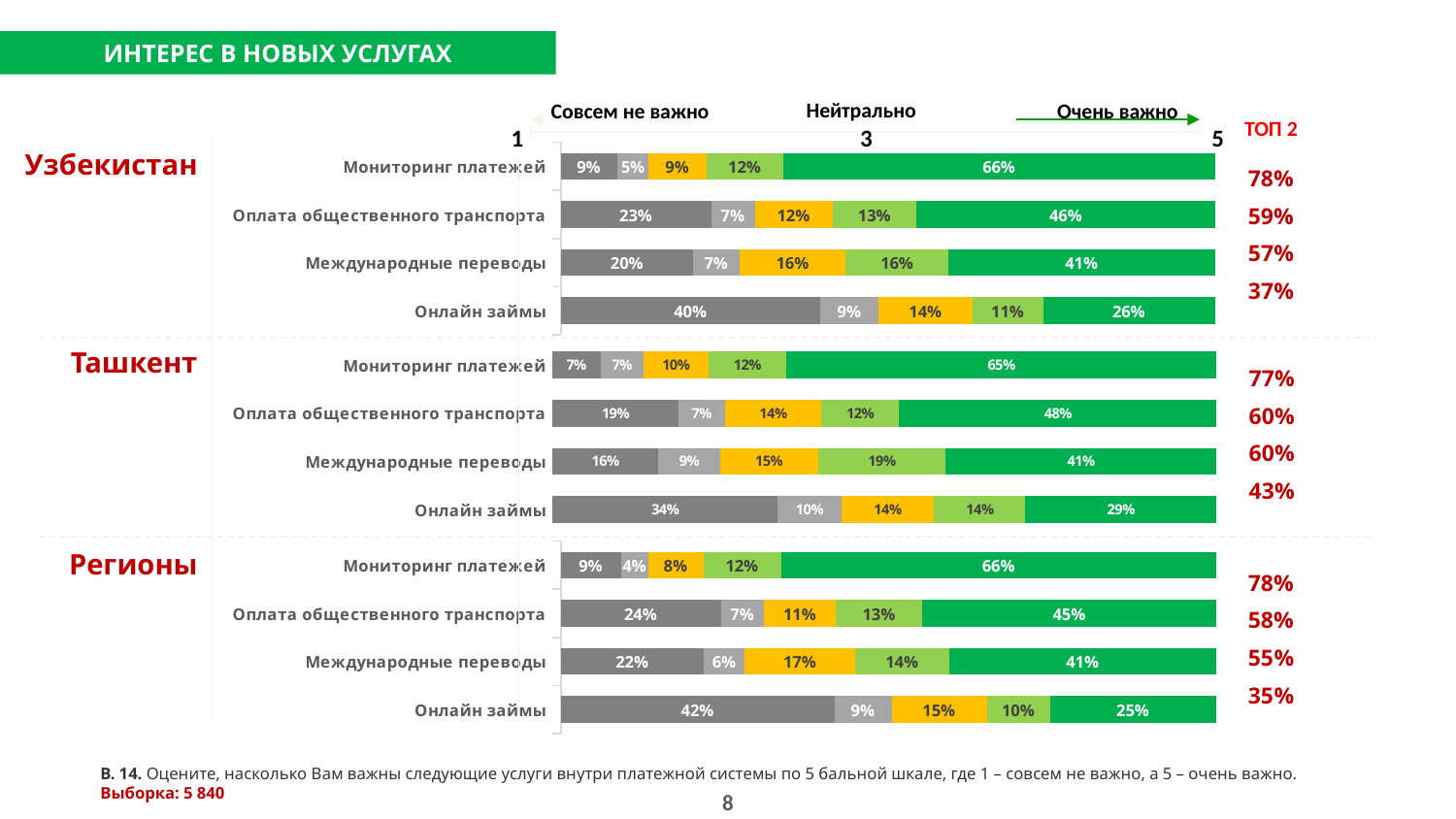
In the Узбекистан chart, which has the larger 'Очень важно' (dark green) share: Оплата общественного транспорта or Международные переводы? Оплата общественного транспорта In the Регионы chart, what is the ТОП 2 value for Международные переводы? 55% What is the sample size (Выборка) stated on the slide? 5 840 In the Узбекистан chart, which service has the highest ТОП 2 value? Мониторинг платежей In the Регионы chart, what is the yellow (neutral, 3) segment value for Международные переводы? 17% In the Регионы chart, what is the difference between the 'Совсем не важно' (dark grey) values for Онлайн займы and Мониторинг платежей? 33% In the Регионы chart, which service has the lowest ТОП 2 value? Онлайн займы In the Ташкент chart, what is the 'Совсем не важно' (leftmost, dark grey) value for Онлайн займы? 34% What type of chart is used for the Узбекистан section? Stacked bar chart How many services (categories) are shown in the Ташкент chart? 4 In the Ташкент chart, what is the difference between the ТОП 2 values for Мониторинг платежей and Онлайн займы? 34% In the Узбекистан chart, what share of respondents rated Мониторинг платежей as 'Очень важно' (the dark green segment)? 66%